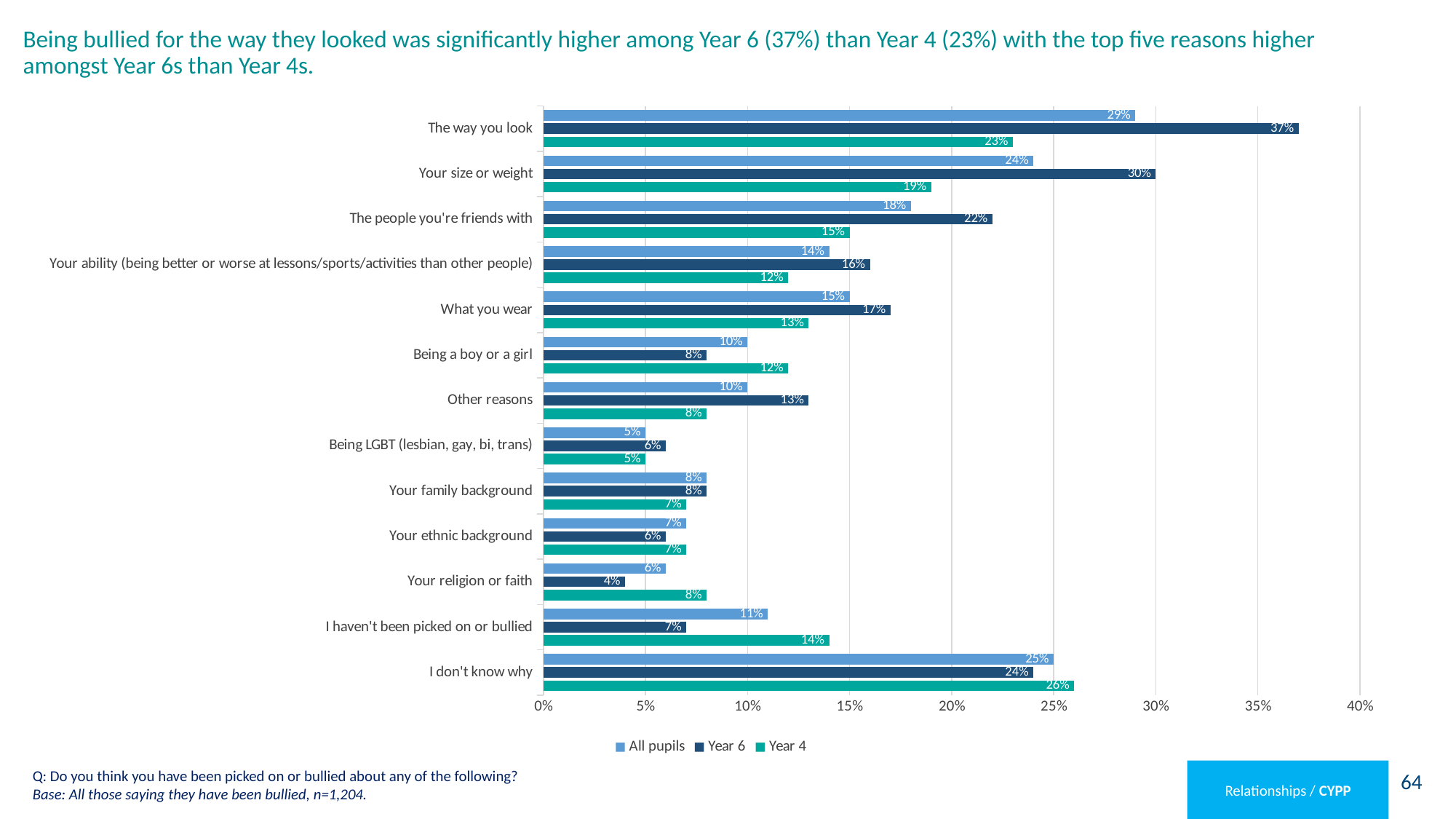
What are the three series listed in the legend? All pupils, Year 6, Year 4 Which is larger for "Being a boy or a girl": the Year 6 value or the Year 4 value? Year 4 Which category has the lowest Year 6 value? Your religion or faith Which category has the highest Year 6 value? The way you look What is the Year 6 value for "The way you look"? 37% How many series does the legend list? 3 Is the Year 6 value for "Your size or weight" greater or less than 25%? greater What is the All pupils value for "I don't know why"? 25% What is the Year 4 value for "Your size or weight"? 19% What kind of chart is shown on the slide? Bar chart How many categories are shown on the chart? 13 What is the difference between the Year 6 and Year 4 values for "The way you look"? 14%